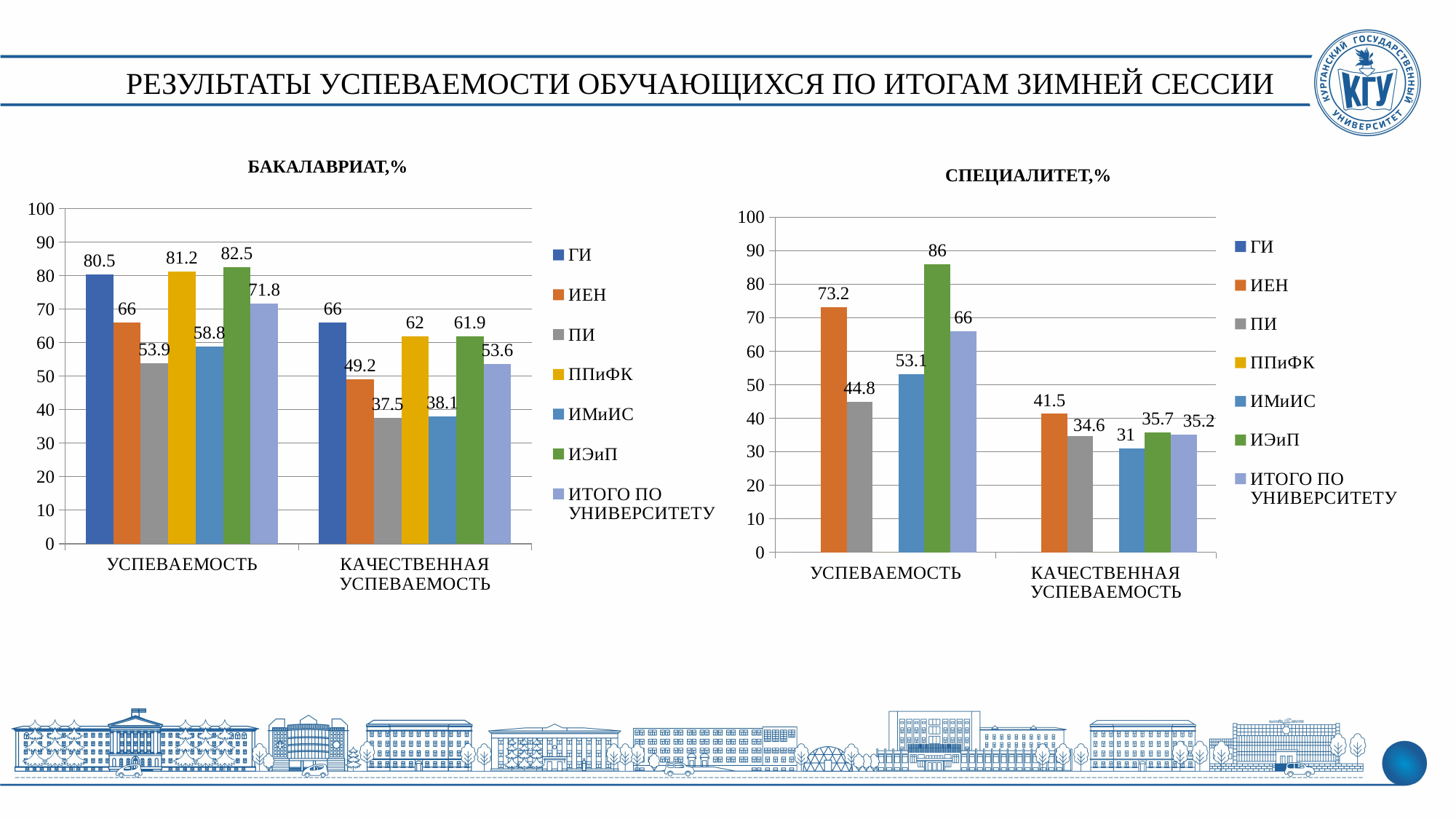
In the СПЕЦИАЛИТЕТ,% chart, which series has the lowest value in the УСПЕВАЕМОСТЬ category? ПИ In the СПЕЦИАЛИТЕТ,% chart, which is larger in the КАЧЕСТВЕННАЯ УСПЕВАЕМОСТЬ category: ИЕН or ПИ? ИЕН In the БАКАЛАВРИАТ,% chart, what is the value for ИТОГО ПО УНИВЕРСИТЕТУ in the КАЧЕСТВЕННАЯ УСПЕВАЕМОСТЬ category? 53.6 In the БАКАЛАВРИАТ,% chart, which series has the highest value in the УСПЕВАЕМОСТЬ category? ИЭиП In the БАКАЛАВРИАТ,% chart, what is the value for ГИ in the УСПЕВАЕМОСТЬ category? 80.5 In the СПЕЦИАЛИТЕТ,% chart, what is the difference between the ИЕН and ПИ values in the УСПЕВАЕМОСТЬ category? 28.4 In the БАКАЛАВРИАТ,% chart, which series has the lowest value in the КАЧЕСТВЕННАЯ УСПЕВАЕМОСТЬ category? ПИ In the СПЕЦИАЛИТЕТ,% chart, what is the value for ИМиИС in the КАЧЕСТВЕННАЯ УСПЕВАЕМОСТЬ category? 31 In the БАКАЛАВРИАТ,% chart, what is the difference between the ГИ values for УСПЕВАЕМОСТЬ and КАЧЕСТВЕННАЯ УСПЕВАЕМОСТЬ? 14.5 In the СПЕЦИАЛИТЕТ,% chart, what is the value for ИЭиП in the УСПЕВАЕМОСТЬ category? 86 What kind of chart is the СПЕЦИАЛИТЕТ,% chart? Bar chart How many series does the legend of the БАКАЛАВРИАТ,% chart list? 7